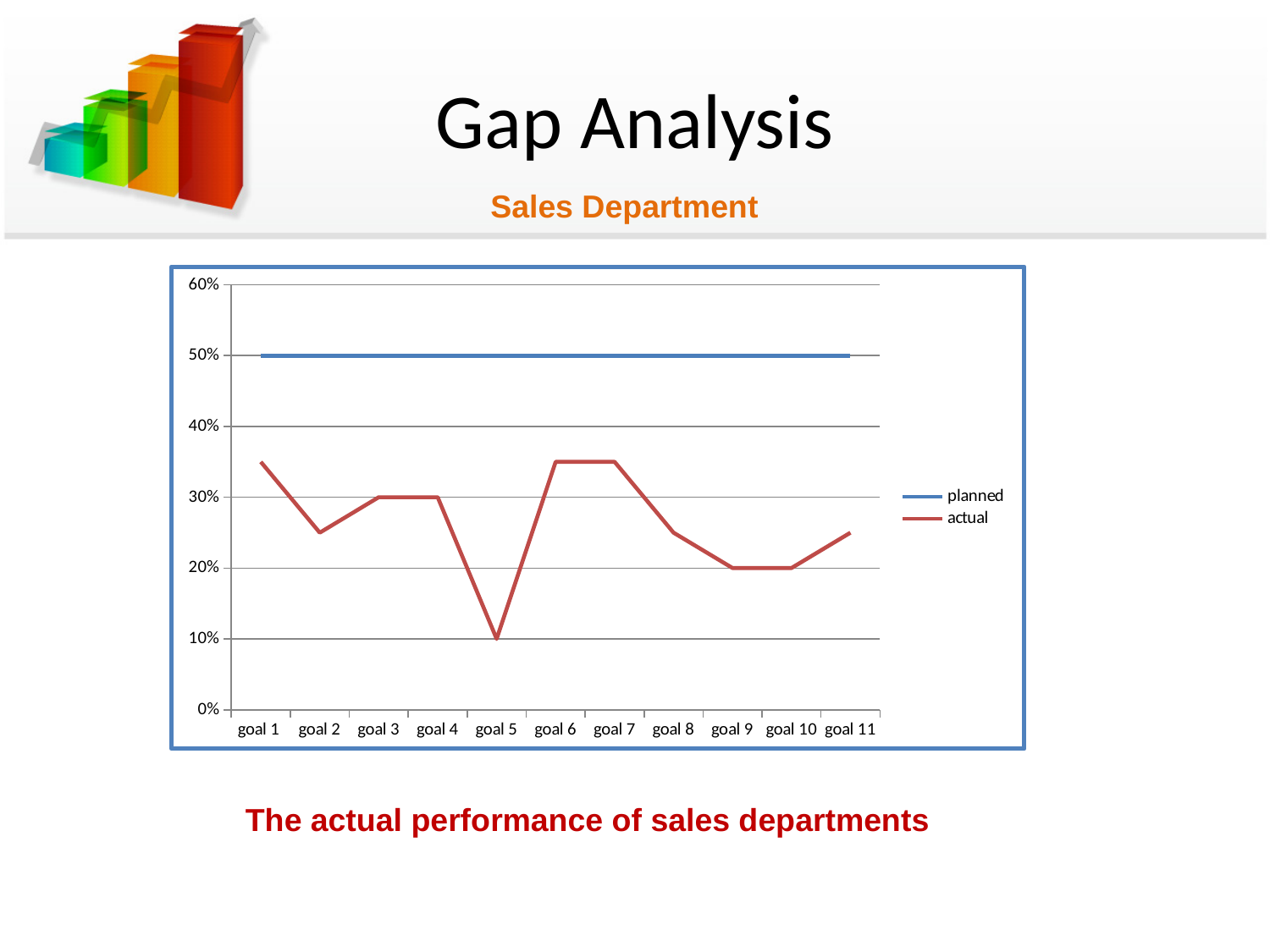
How many series does the legend list? 2 What is the actual value for goal 3? 30% How many goals are shown along the x axis? 11 What is the planned value shown for each goal? 50% Is the actual value for goal 6 greater or less than 30%? greater What is the actual value for goal 5? 10% What is the actual value for goal 9? 20% Is the actual value for goal 2 greater or less than 30%? less Which goal has the lowest actual value? goal 5 What kind of chart is shown on the slide? line chart What is the difference between the planned value and the actual value for goal 5? 40% Does the actual line rise or fall from goal 4 to goal 5? fall